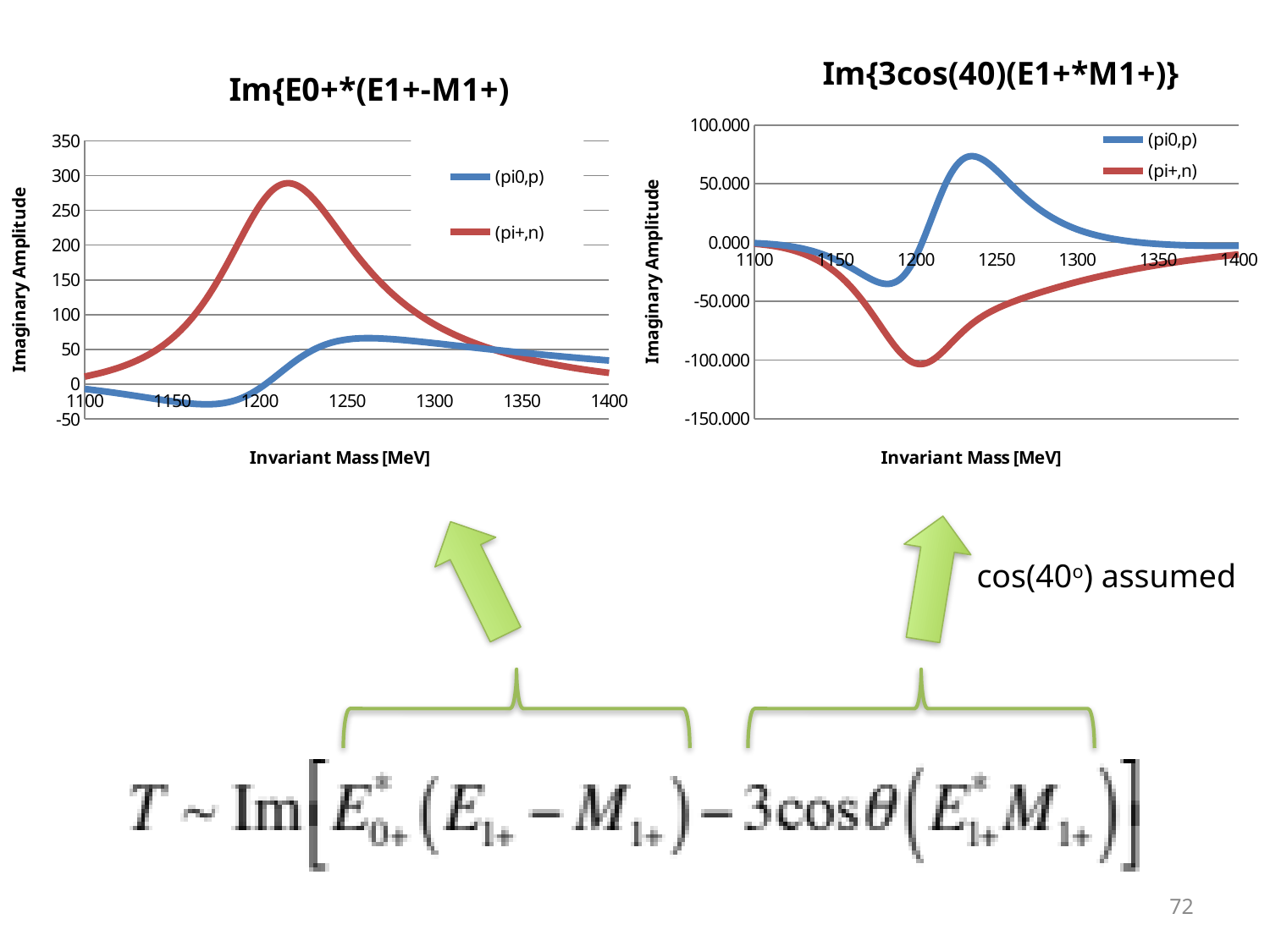
In the right chart, Im{3cos(40)(E1+*M1+)}, what colour is the (pi0,p) series line? blue In the left chart, Im{E0+*(E1+-M1+)}, which series reaches the higher peak value, (pi0,p) or (pi+,n)? (pi+,n) How many series does the legend of the right chart, Im{3cos(40)(E1+*M1+)}, list? 2 In the left chart, Im{E0+*(E1+-M1+)}, is the peak value of the (pi0,p) series greater or less than 100? less In the right chart, Im{3cos(40)(E1+*M1+)}, is the peak value of the (pi0,p) series greater or less than 50.000? greater In the right chart, Im{3cos(40)(E1+*M1+)}, does the (pi+,n) series rise or fall between 1200 and 1400 MeV? rise In the left chart, Im{E0+*(E1+-M1+)}, is the peak value of the (pi+,n) series greater or less than 250? greater What is the x-axis label of the left chart, Im{E0+*(E1+-M1+)}? Invariant Mass [MeV] What kind of chart is the left chart titled Im{E0+*(E1+-M1+)}? line chart In the right chart, Im{3cos(40)(E1+*M1+)}, which series has the lower minimum value, (pi0,p) or (pi+,n)? (pi+,n) In the left chart, Im{E0+*(E1+-M1+)}, does the (pi+,n) series rise or fall between 1250 and 1400 MeV? fall